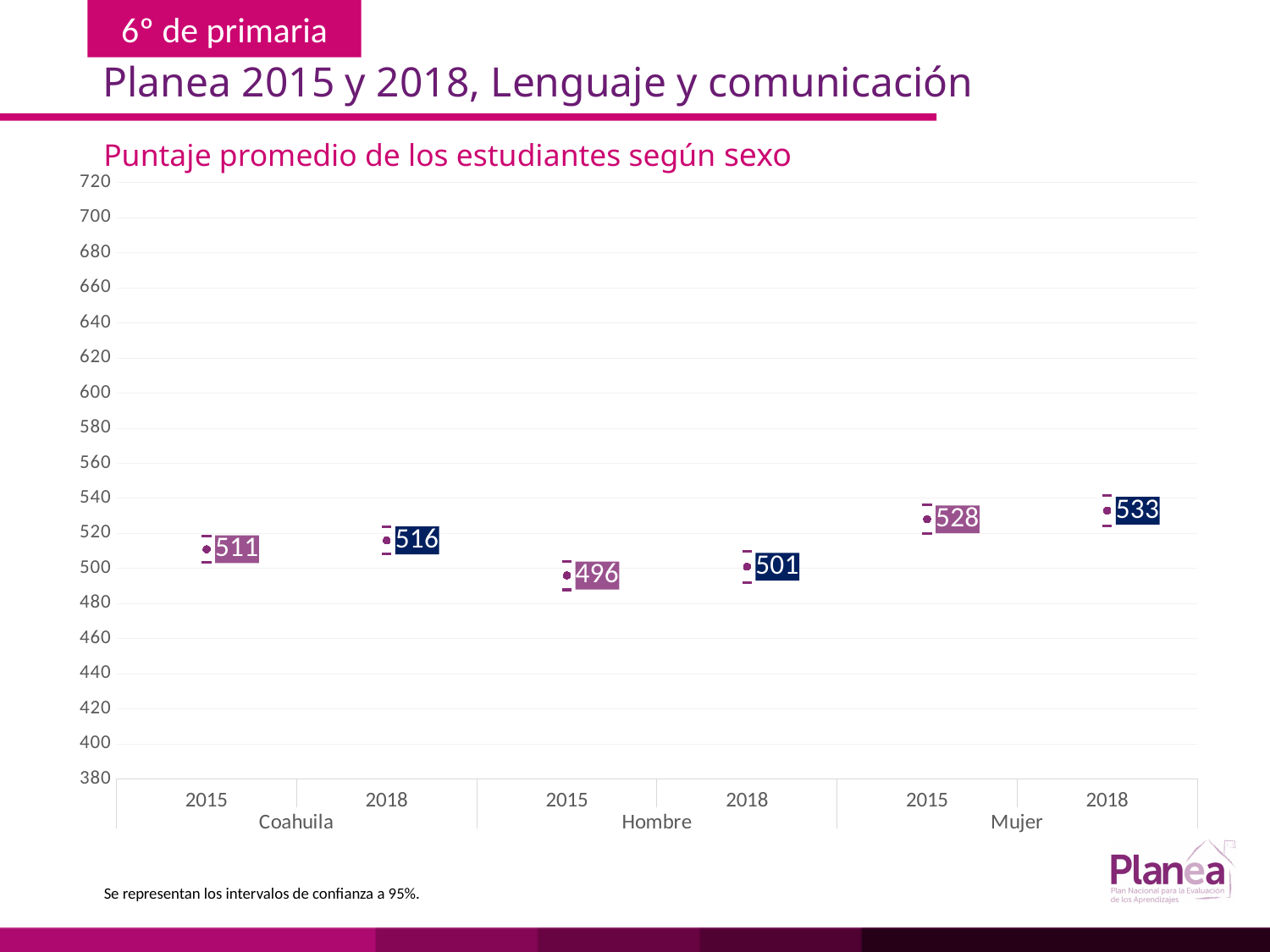
By how much did the Coahuila score change from 2015 to 2018? 5 How many data points are plotted on the chart? 6 What is the average score for Hombre in 2018? 501 What is the average score for Mujer in 2018? 533 Which group and year has the lowest average score? Hombre 2015 Which group and year has the highest average score? Mujer 2018 Does the score for each group rise or fall from 2015 to 2018? rise What is the average score for Coahuila in 2015? 511 Which is larger, the Hombre 2015 score or the Coahuila 2015 score? Coahuila 2015 What is the difference between the Mujer 2018 score and the Hombre 2018 score? 32 What is the title of the chart? Puntaje promedio de los estudiantes según sexo What is the average score for Mujer in 2015? 528